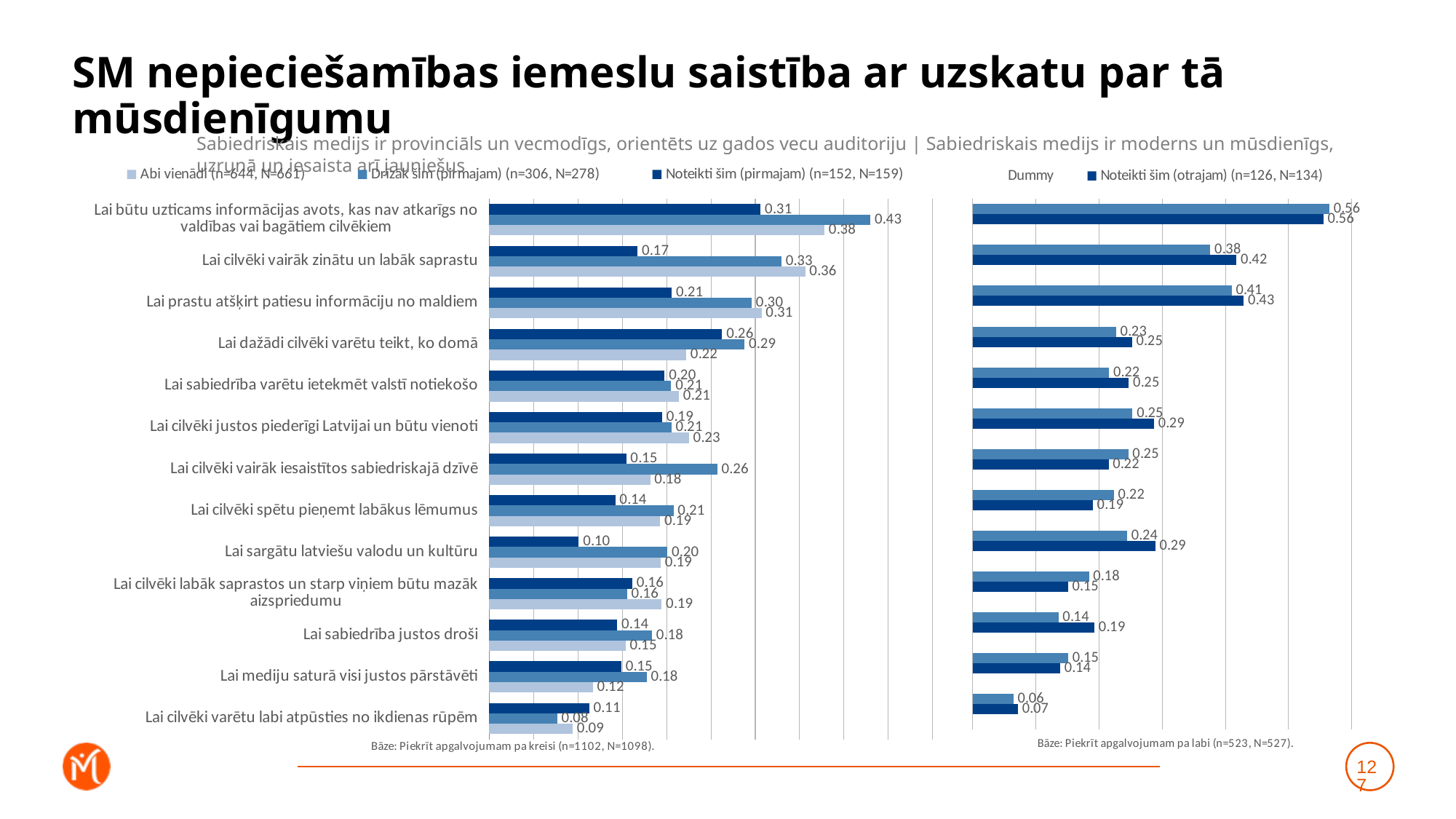
How many series does the legend of the left chart list? 3 How many categories are shown in the left chart? 13 What type of chart is the left chart? Bar chart In the left chart, what is the value of 'Drīzāk šim (pirmajam)' for 'Lai mediju saturā visi justos pārstāvēti'? 0.18 In the left chart, what is the value of 'Abi vienādi' for 'Lai cilvēki vairāk zinātu un labāk saprastu'? 0.36 In the left chart, what is the value of 'Noteikti šim (pirmajam)' for 'Lai būtu uzticams informācijas avots, kas nav atkarīgs no valdības vai bagātiem cilvēkiem'? 0.31 In the right chart, which category has the lowest value for 'Noteikti šim (otrajam)'? Lai cilvēki varētu labi atpūsties no ikdienas rūpēm In the left chart, what is the difference between the 'Drīzāk šim (pirmajam)' and 'Noteikti šim (pirmajam)' values for 'Lai cilvēki vairāk iesaistītos sabiedriskajā dzīvē'? 0.11 In the right chart, what is the value of 'Noteikti šim (otrajam)' for 'Lai sargātu latviešu valodu un kultūru'? 0.29 In the left chart, which is larger for 'Lai sargātu latviešu valodu un kultūru': 'Noteikti šim (pirmajam)' or 'Abi vienādi'? Abi vienādi In the left chart, which category has the highest value for 'Drīzāk šim (pirmajam)'? Lai būtu uzticams informācijas avots, kas nav atkarīgs no valdības vai bagātiem cilvēkiem In the right chart, what is the value of 'Noteikti šim (otrajam)' for 'Lai prastu atšķirt patiesu informāciju no maldiem'? 0.43